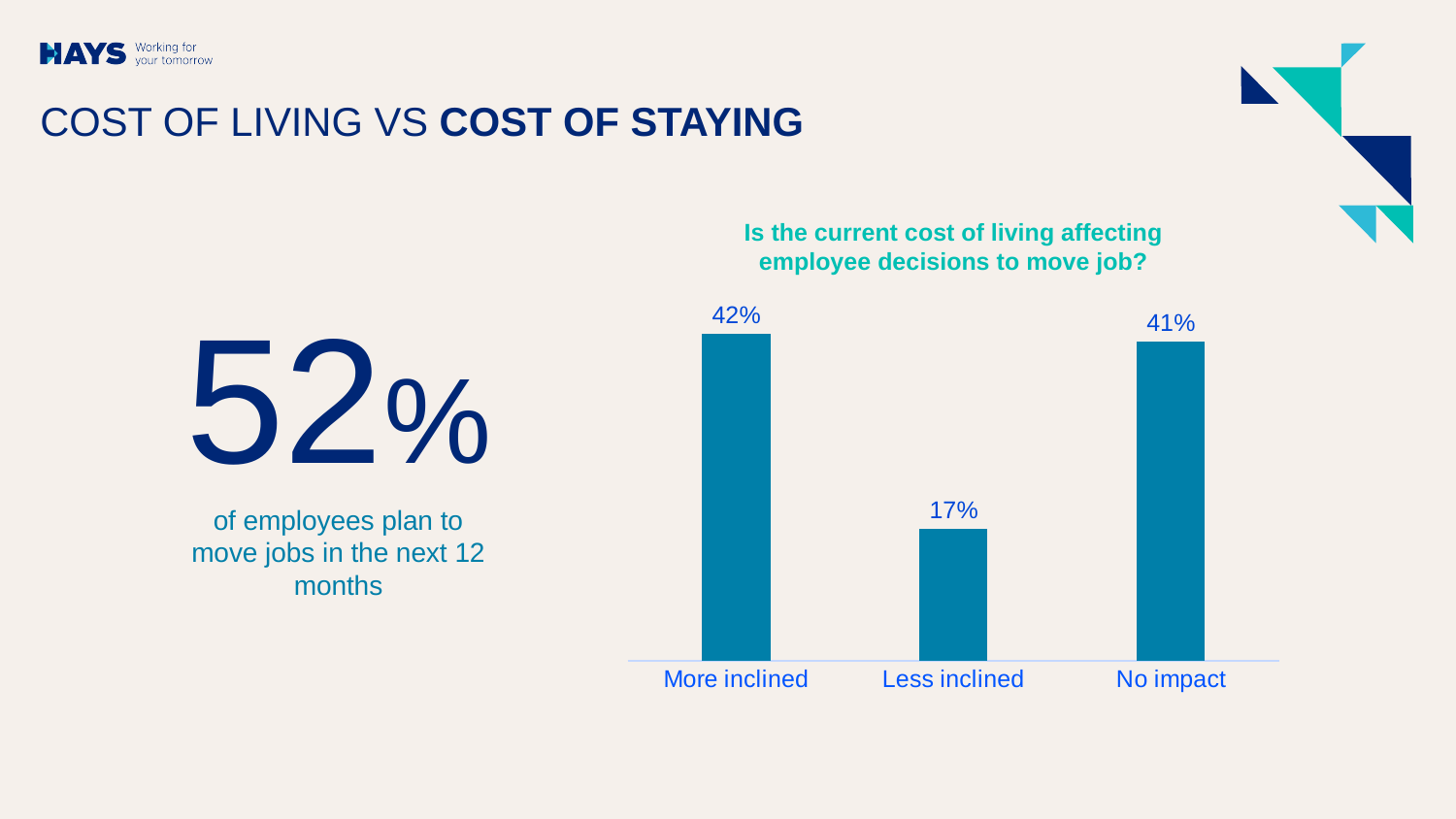
Which is larger, the value for "Less inclined" or the value for "No impact"? No impact What is the total of the three values shown in the chart? 100% What is the value for "Less inclined" in the chart? 17% Which category has the highest value in the chart? More inclined Which category has the lowest value in the chart? Less inclined What kind of chart is shown on the slide? Bar chart What is the value for "No impact" in the chart? 41% How many categories are shown in the chart? 3 What is the difference between the values for "No impact" and "Less inclined"? 24% What is the value for "More inclined" in the chart? 42% What is the title of the chart? Is the current cost of living affecting employee decisions to move job? What is the difference between the values for "More inclined" and "Less inclined"? 25%